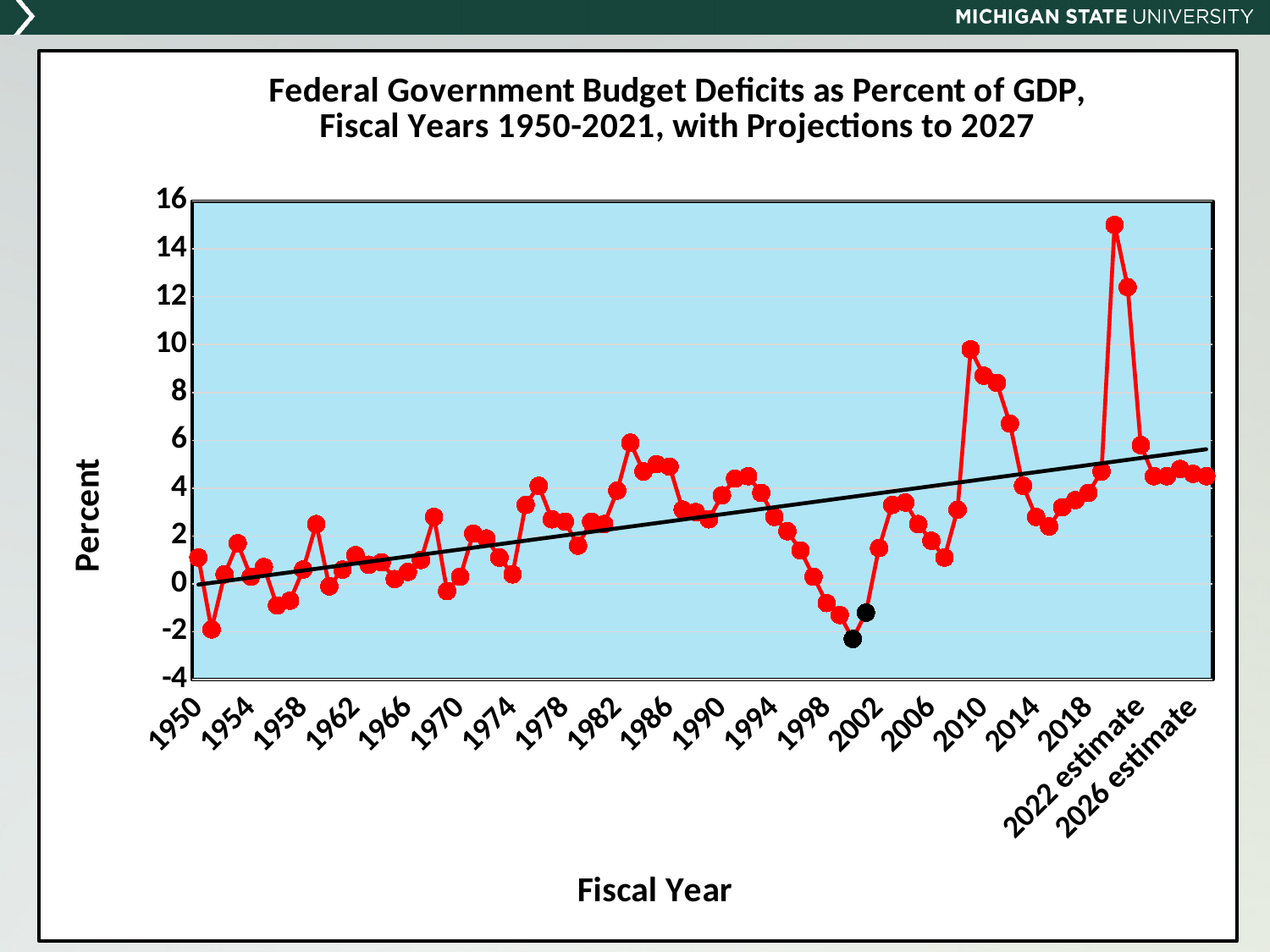
Which has the larger value, 2010 or 2014? 2010 Is the value for 1986 greater or less than 4? greater Which has the larger value, 1986 or 1950? 1986 What is the label on the vertical axis of the chart? Percent Is the value for 2010 greater or less than 8? greater What is the title of the chart? Federal Government Budget Deficits as Percent of GDP, Fiscal Years 1950-2021, with Projections to 2027 According to the straight trend line, do the values generally rise or fall from 1950 to 2027? rise Is the value for 1998 greater or less than 0? less What kind of chart is shown on the slide? line chart